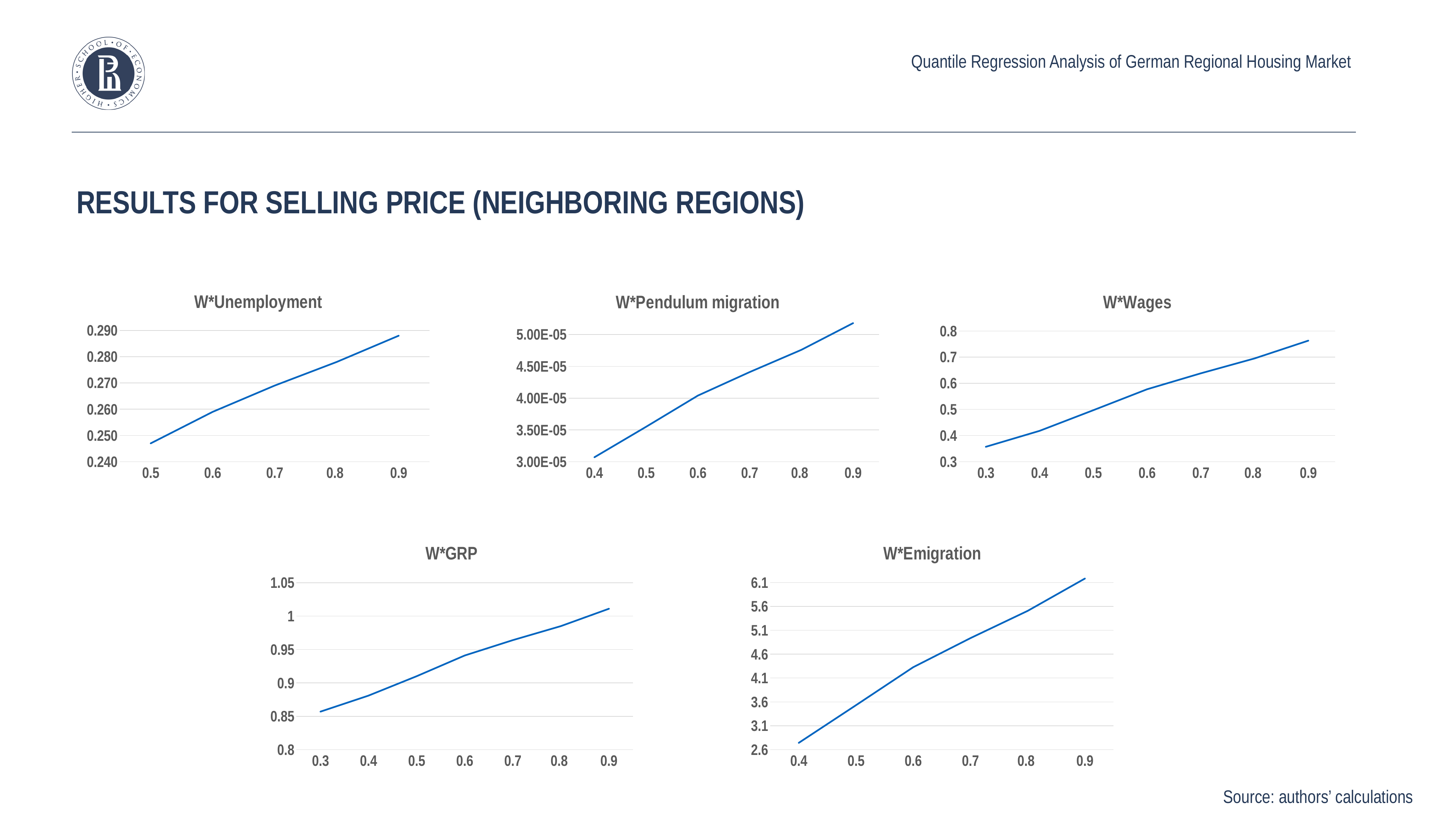
In the W*Unemployment chart, how many quantile points are plotted along the x axis? 5 In the W*Wages chart, how many quantile points are plotted along the x axis? 7 In the W*Wages chart, at which quantile is the value lowest? 0.3 In the W*Pendulum migration chart, is the value at quantile 0.9 greater or less than 5.00E-05? greater In the W*Unemployment chart, is the value at quantile 0.5 greater or less than 0.250? less How many charts are shown on the slide? 5 In the W*Emigration chart, is the value at quantile 0.4 greater or less than 3.1? less In the W*GRP chart, do the values rise or fall along the x axis? rise In the W*GRP chart, at which quantile is the value highest? 0.9 What kind of chart is the W*Unemployment chart? line chart In the W*Emigration chart, do the values rise or fall as the quantile increases from 0.4 to 0.9? rise